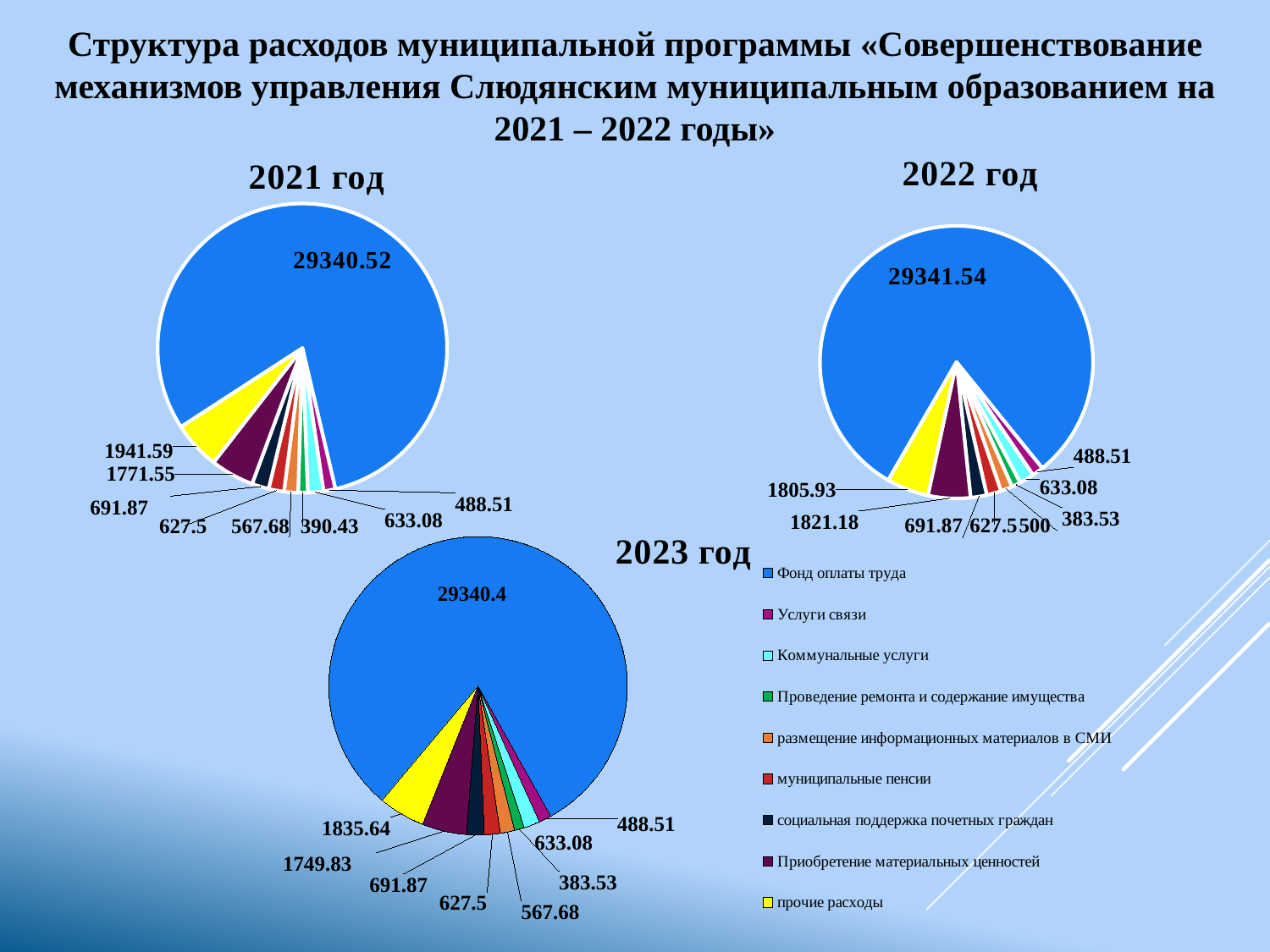
What is the last entry in the legend? прочие расходы In the 2021 год chart, what is the smallest labeled value? 390.43 In the 2021 год chart, what is the value of the largest slice? 29340.52 How many pie charts are on the slide? 3 In the 2023 год chart, what is the smallest labeled value? 383.53 In the 2023 год chart, what is the value of the largest slice? 29340.4 What type of charts are shown on the slide? Pie charts What is the difference between the largest slice in the 2021 год chart and the largest slice in the 2023 год chart? 0.12 In the 2022 год chart, what is the value of the largest slice? 29341.54 Which is larger: the yellow (прочие расходы) slice in the 2021 год chart or the yellow slice in the 2023 год chart? 2021 год (1941.59) How many categories does the legend list? 9 In the 2021 год chart, which category has the largest slice? Фонд оплаты труда